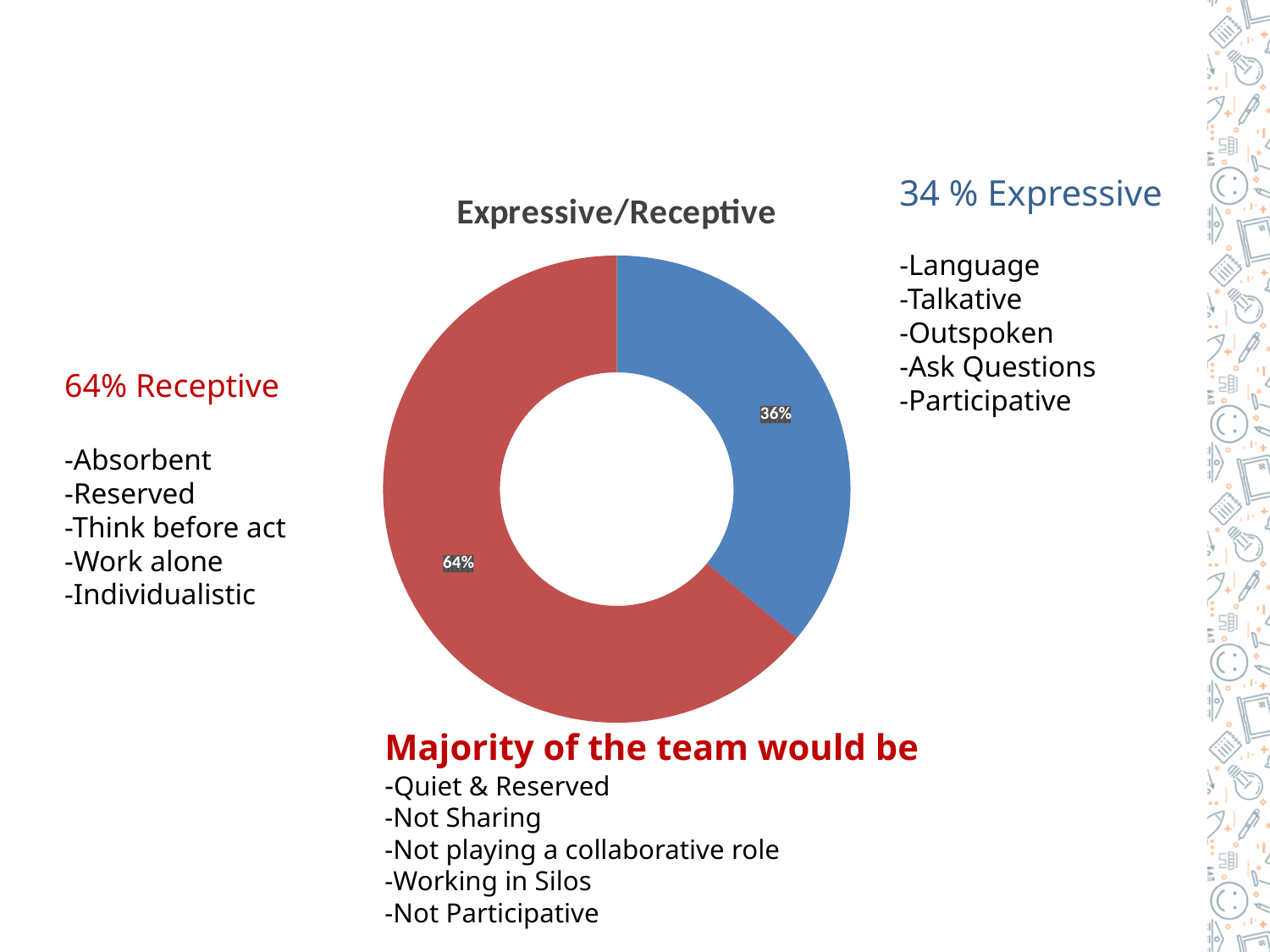
What share of the chart does the red slice represent? 64% What is the title of the chart? Expressive/Receptive What is the difference between the two slice values shown on the chart? 28 percentage points What value is labelled on the blue slice of the chart? 36% Which slice of the chart is the largest? the red slice (64%) Which slice of the chart is the smallest? the blue slice (36%) What kind of chart is shown on the slide? doughnut chart What value is labelled on the red slice of the chart? 64% How many slices does the chart have? 2 Which is larger, the red slice or the blue slice? the red slice Is the value of the blue slice greater or less than 50%? less What colours are used for the two slices of the chart? red and blue